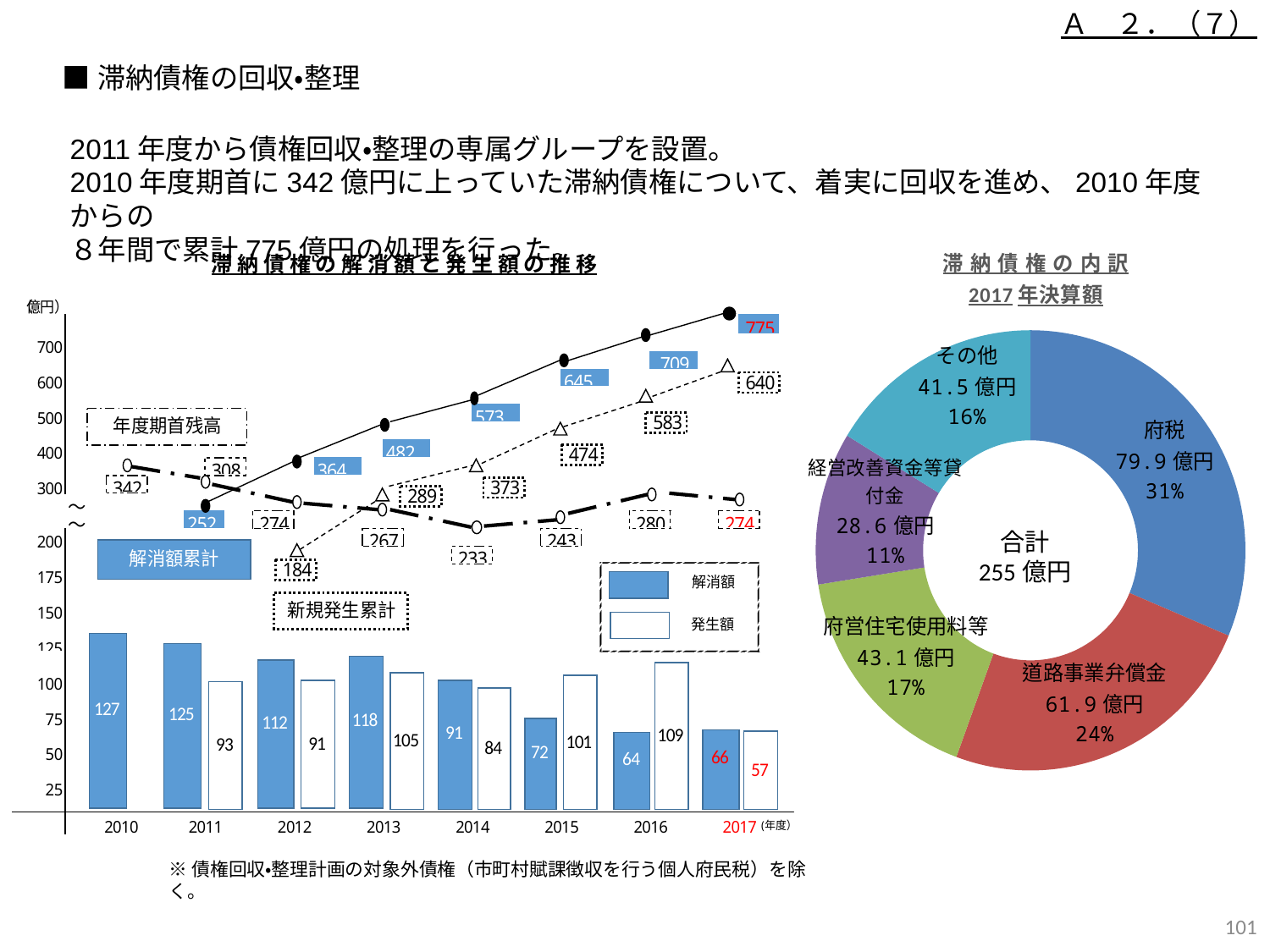
In the right chart (滞納債権の内訳 2017年決算額), what is the amount for 府税? 79.9億円 In the left chart (滞納債権の解消額と発生額の推移), what is the 解消額 value for 2010? 127 In the right chart (滞納債権の内訳 2017年決算額), what share does 道路事業弁償金 represent? 24% In the left chart (滞納債権の解消額と発生額の推移), what is the 発生額 value for 2016? 109 In the right chart (滞納債権の内訳 2017年決算額), which category has the smallest share? 経営改善資金等貸付金 In the left chart (滞納債権の解消額と発生額の推移), how many series does the legend list? 2 In the left chart (滞納債権の解消額と発生額の推移), does the 解消額累計 line rise or fall from 2011 to 2017? rise What kind of chart is the right chart (滞納債権の内訳 2017年決算額)? pie (donut) chart In the left chart (滞納債権の解消額と発生額の推移), which year has the lowest 解消額 bar? 2016 In the left chart (滞納債権の解消額と発生額の推移), what is the difference between the 解消額 and 発生額 values for 2017? 9 In the left chart (滞納債権の解消額と発生額の推移), which is larger for 2015, the 解消額 or the 発生額? 発生額 In the left chart (滞納債権の解消額と発生額の推移), what is the 解消額累計 value for 2017? 775